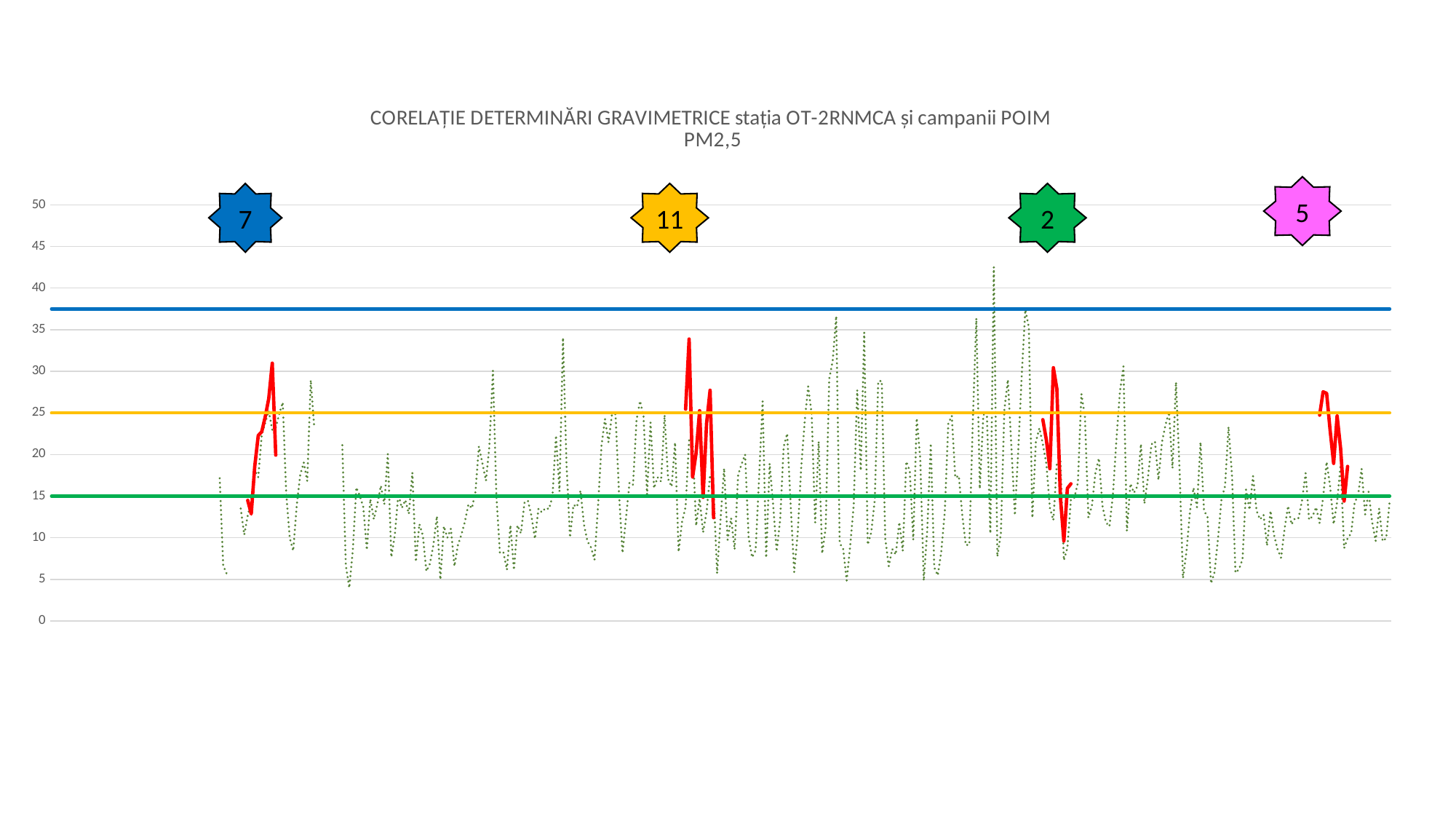
What number is shown in the blue star-shaped label? 7 What number is shown in the pink star-shaped label? 5 What is the title of the chart? CORELAȚIE DETERMINĂRI GRAVIMETRICE stația OT-2RNMCA și campanii POIM PM2,5 How many horizontal reference lines are drawn across the chart? 3 Is the blue horizontal reference line greater or less than 40? less What number is shown in the yellow star-shaped label? 11 Is the highest peak of the dotted green line greater or less than 40? greater Is the blue horizontal reference line greater or less than 35? greater What is the highest value shown on the vertical axis? 50 How many star-shaped labels are placed above the chart? 4 What kind of chart is shown on the slide? line chart What number is shown in the green star-shaped label? 2